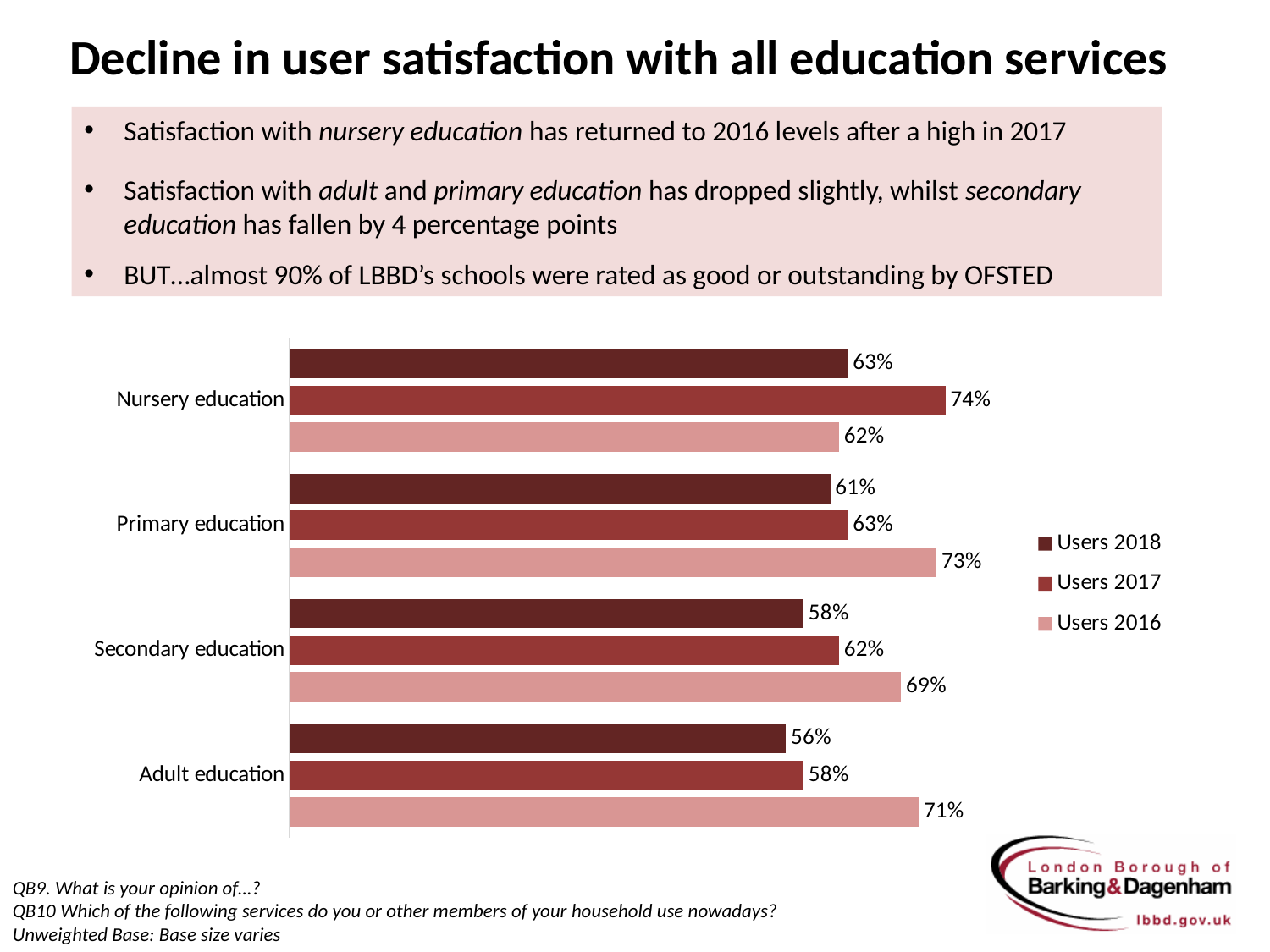
What is the Users 2016 value for Primary education? 73% How many series does the legend list? 3 What is the difference between the Users 2017 and Users 2018 values for Nursery education? 11% What kind of chart is shown on the slide? Bar chart What is the Users 2018 value for Adult education? 56% Which category has the lowest Users 2018 value? Adult education What is the difference between the Users 2016 and Users 2018 values for Adult education? 15% How many education categories are shown on the chart? 4 Which is larger: the Users 2016 value for Secondary education or the Users 2016 value for Nursery education? Secondary education What is the Users 2018 value for Nursery education? 63% What is the Users 2017 value for Secondary education? 62% Which category has the highest Users 2017 value? Nursery education